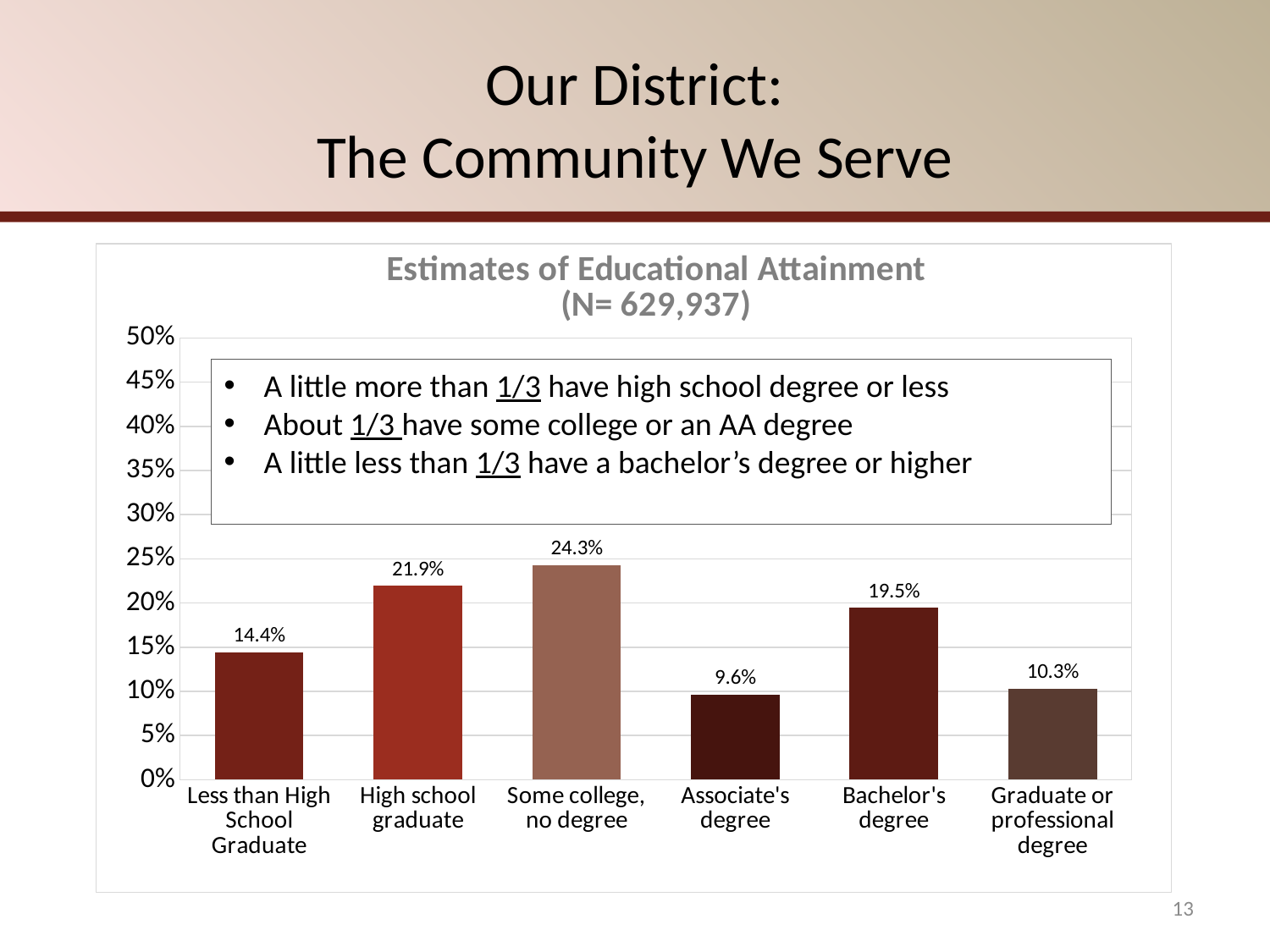
How many categories are shown on the x axis? 6 Which category has the lowest value? Associate's degree What kind of chart is shown? bar chart Which category has the highest value? Some college, no degree Which is larger, the value for Less than High School Graduate or the value for Bachelor's degree? Bachelor's degree Is the value for High school graduate greater or less than 20%? greater What is the title of the chart? Estimates of Educational Attainment (N= 629,937) What is the value for Graduate or professional degree? 10.3% What is the difference between the values for Some college, no degree and Bachelor's degree? 4.8% What is the total of the values for Less than High School Graduate and High school graduate? 36.3% What is the value for High school graduate? 21.9% What is the value for Associate's degree? 9.6%